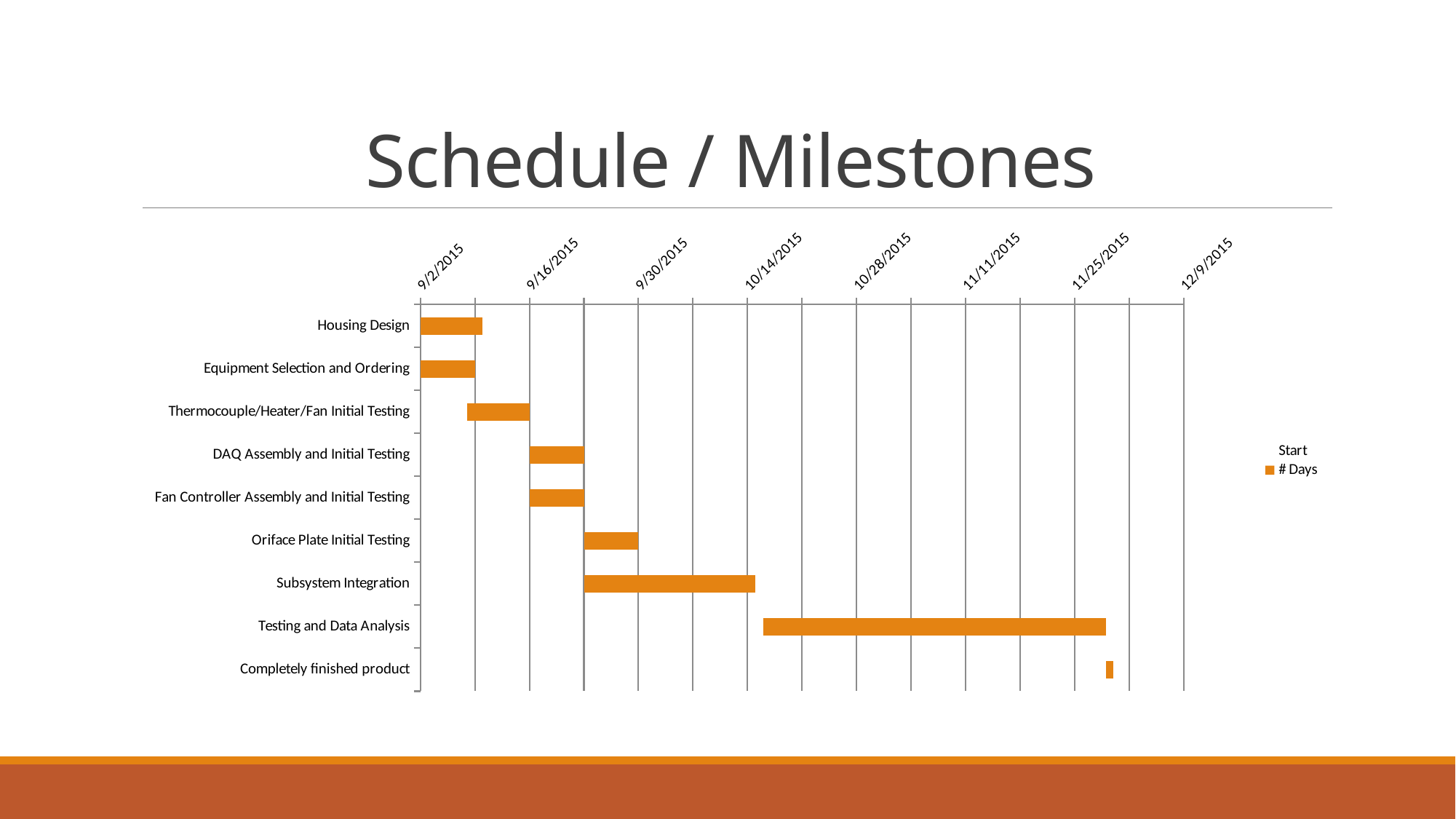
Does the Housing Design bar end before or after the 9/16/2015 gridline? Before Which bar is longer, Thermocouple/Heater/Fan Initial Testing or Testing and Data Analysis? Testing and Data Analysis What is the first date shown on the horizontal axis of the chart? 9/2/2015 How many tasks are listed on the vertical axis of the chart? 9 What is the title of the slide containing the chart? Schedule / Milestones What are the two entries listed in the chart legend? Start and # Days Which task has the shortest bar in the chart? Completely finished product Does the Testing and Data Analysis bar extend past the 11/11/2015 gridline? Yes How many series does the chart legend list? 2 Which bar is longer, Subsystem Integration or Oriface Plate Initial Testing? Subsystem Integration What kind of chart is shown on the slide? Bar chart (Gantt chart) Which task has the longest bar in the chart? Testing and Data Analysis